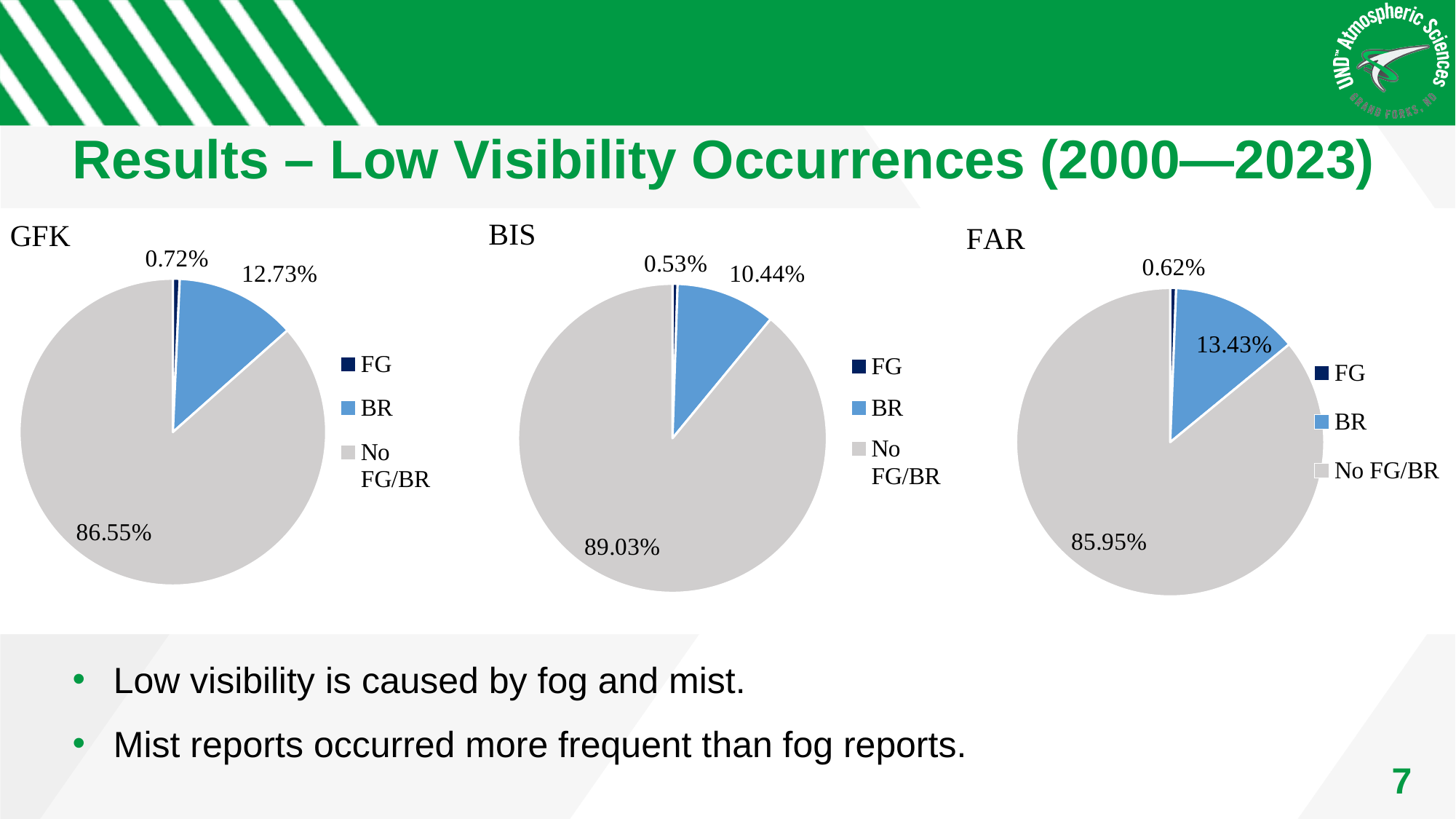
In the BIS pie chart, what percentage is shown for FG? 0.53% In the BIS pie chart, what percentage is shown for No FG/BR? 89.03% What type of chart is used for the FAR data? Pie chart Which is larger: the BR share in the GFK chart or the BR share in the BIS chart? GFK How many entries does the legend of the GFK chart list? 3 How many slices does the BIS pie chart have? 3 In the BIS chart, what colour is the BR slice? Blue In the GFK pie chart, what percentage is shown for BR? 12.73% In the GFK pie chart, which category has the smallest share? FG In the FAR pie chart, which category has the largest share? No FG/BR In the FAR pie chart, what percentage is shown for FG? 0.62% In the FAR pie chart, what is the difference between the BR share and the FG share? 12.81%